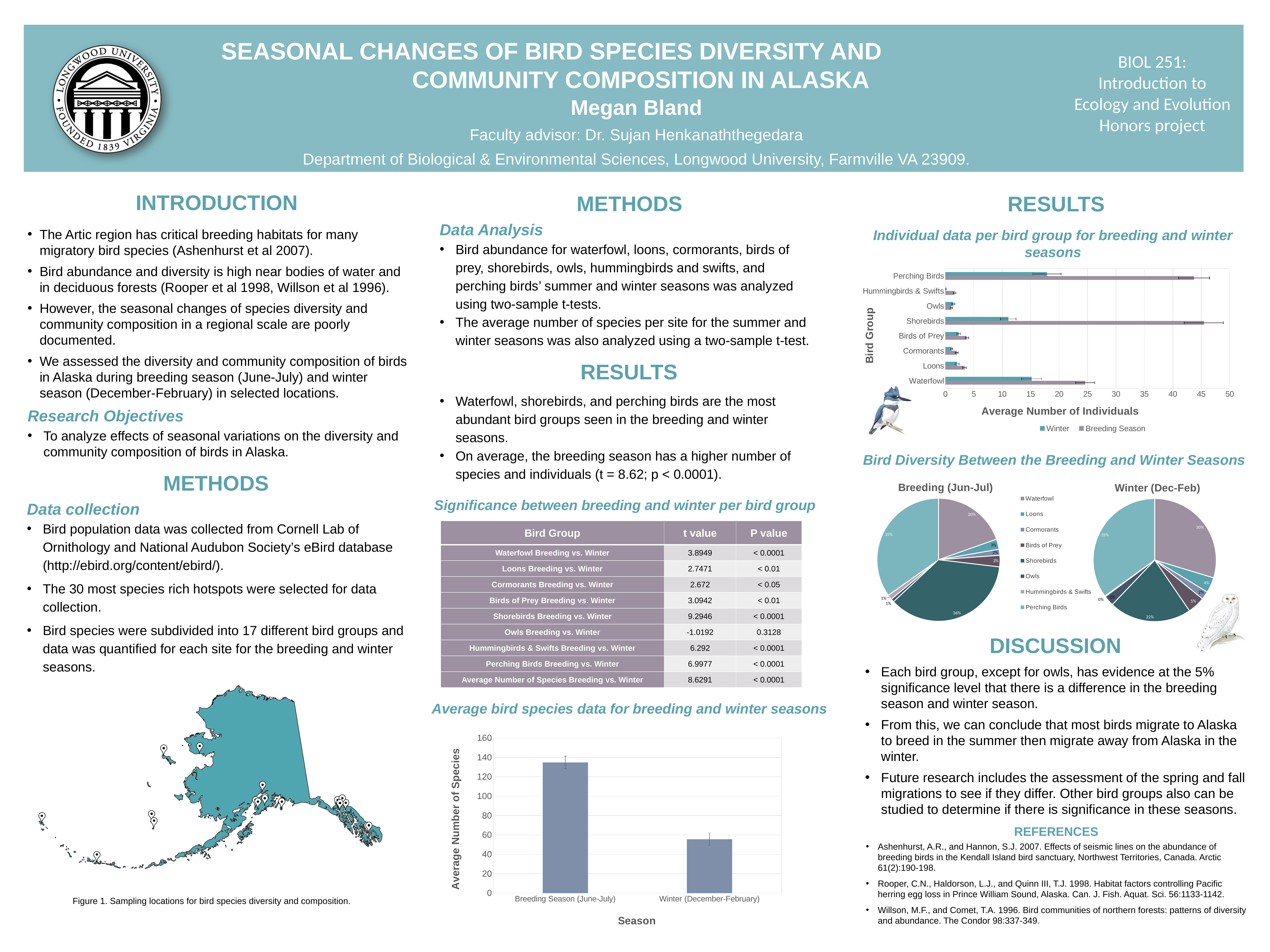
In the chart titled 'Average bird species data for breeding and winter seasons', is the value for Breeding Season (June-July) greater or less than 120? greater In the chart titled 'Individual data per bird group for breeding and winter seasons', is the Winter value for Perching Birds greater or less than 15? greater In the chart titled 'Individual data per bird group for breeding and winter seasons', how many bird groups are listed on the y axis? 8 In the 'Winter (Dec-Feb)' pie chart, which bird group has the largest share? Perching Birds In the chart titled 'Average bird species data for breeding and winter seasons', what is the label of the y axis? Average Number of Species In the 'Breeding (Jun-Jul)' pie chart, what share do Shorebirds have? 36% In the chart titled 'Individual data per bird group for breeding and winter seasons', how many series does the legend list? 2 In the chart titled 'Individual data per bird group for breeding and winter seasons', which is larger for Waterfowl, the Winter value or the Breeding Season value? Breeding Season In the chart titled 'Average bird species data for breeding and winter seasons', how many categories are shown on the x axis? 2 In the 'Winter (Dec-Feb)' pie chart, what share does Waterfowl have? 30% In the chart titled 'Individual data per bird group for breeding and winter seasons', is the Breeding Season value for Shorebirds greater or less than 40? greater In the chart titled 'Individual data per bird group for breeding and winter seasons', what kind of chart is it? bar chart